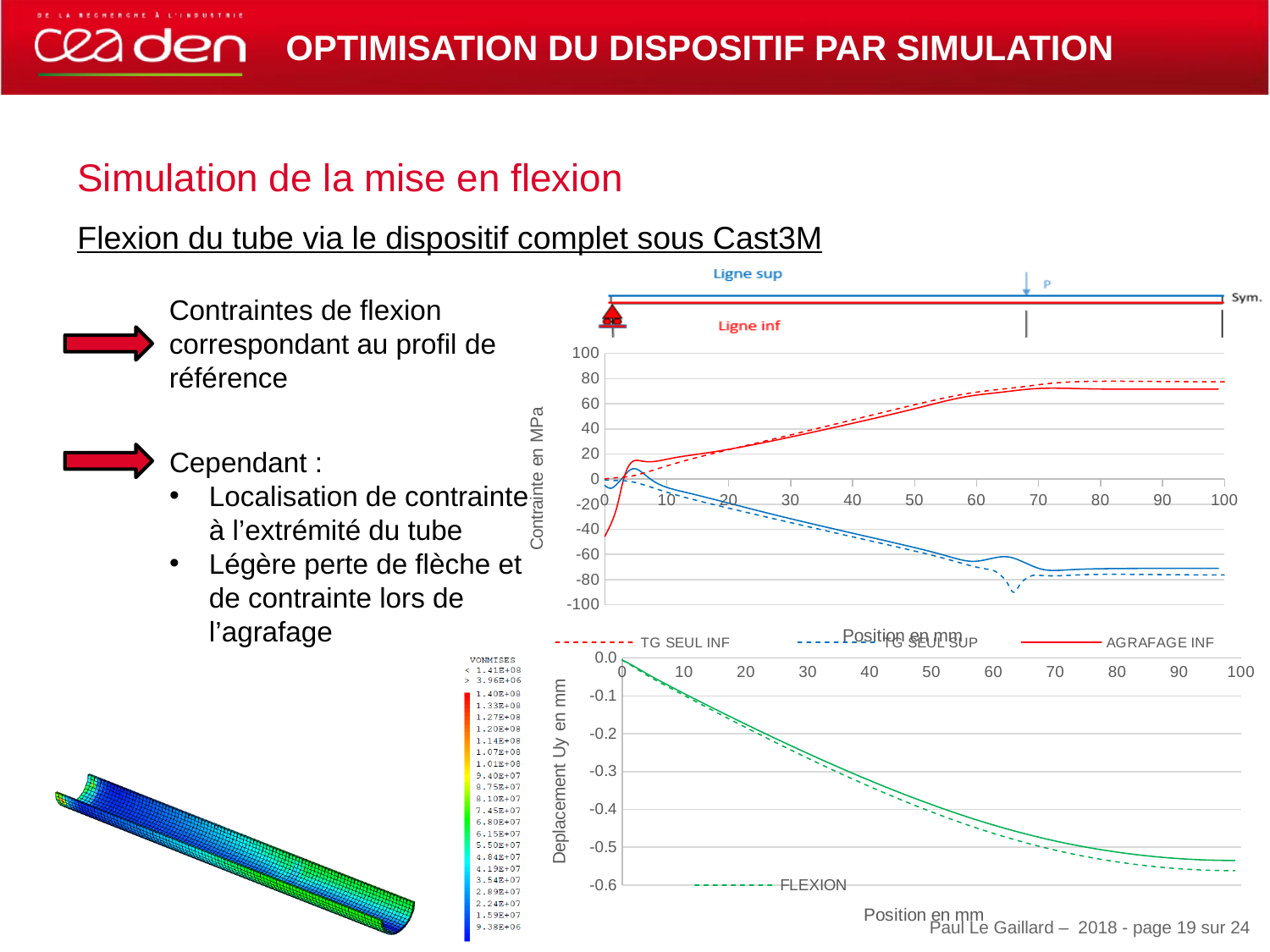
In the top chart (Contrainte en MPa), which is larger at position 100: TG SEUL INF or AGRAFAGE INF? TG SEUL INF What kind of chart is the bottom chart (Deplacement Uy en mm)? line chart In the top chart (Contrainte en MPa), does the AGRAFAGE INF series rise or fall overall as position increases from 0 to 100 mm? rise What is the y-axis title of the top chart? Contrainte en MPa In the bottom chart (Deplacement Uy en mm), do the FLEXION values rise or fall as position increases from 0 to 100 mm? fall In the top chart (Contrainte en MPa), is the value of TG SEUL SUP at position 100 greater or less than -60? less In the top chart (Contrainte en MPa), is the value of AGRAFAGE INF at position 100 greater or less than 60? greater What kind of chart is the top chart (Contrainte en MPa)? line chart What is the y-axis title of the bottom chart? Deplacement Uy en mm In the bottom chart (Deplacement Uy en mm), is the solid FLEXION value at position 100 greater or less than -0.5? less In the top chart (Contrainte en MPa), which is larger at position 100: AGRAFAGE INF or TG SEUL SUP? AGRAFAGE INF